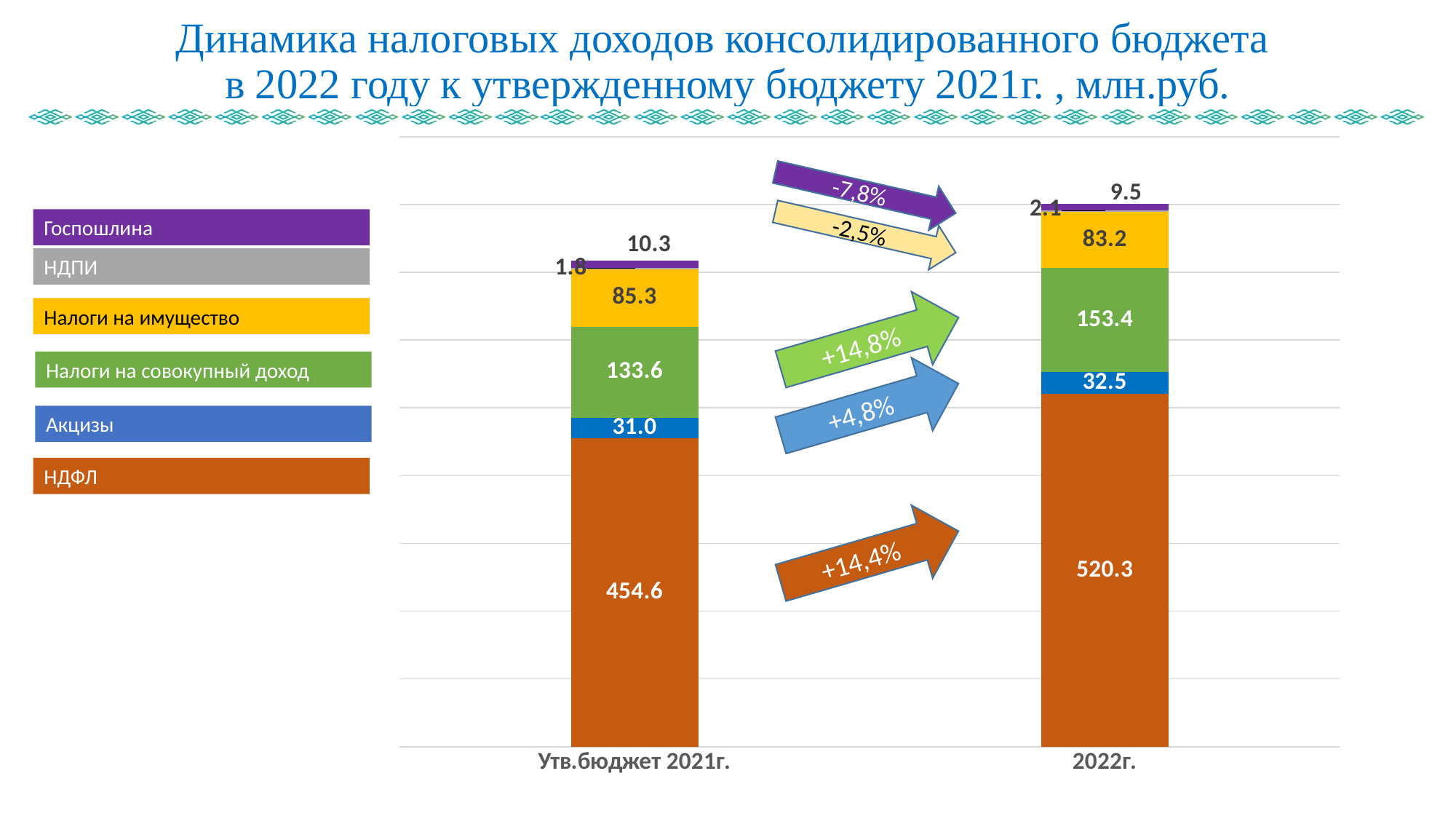
What is the value of Налоги на совокупный доход for 2022г.? 153.4 What is the value of Акцизы for Утв.бюджет 2021г.? 31.0 What is the value of НДФЛ for Утв.бюджет 2021г.? 454.6 How many series does the legend list? 6 By how much does НДФЛ in 2022г. exceed НДФЛ in Утв.бюджет 2021г.? 65.7 What is the value of НДФЛ for 2022г.? 520.3 What is the value of Госпошлина for 2022г.? 9.5 Which series has the largest value in the 2022г. bar? НДФЛ What type of chart is shown on the slide? Stacked bar chart How many categories are shown on the x axis of the chart? 2 Which is larger: Налоги на имущество for Утв.бюджет 2021г. or for 2022г.? Утв.бюджет 2021г. Which series has the smallest value in the Утв.бюджет 2021г. bar? НДПИ